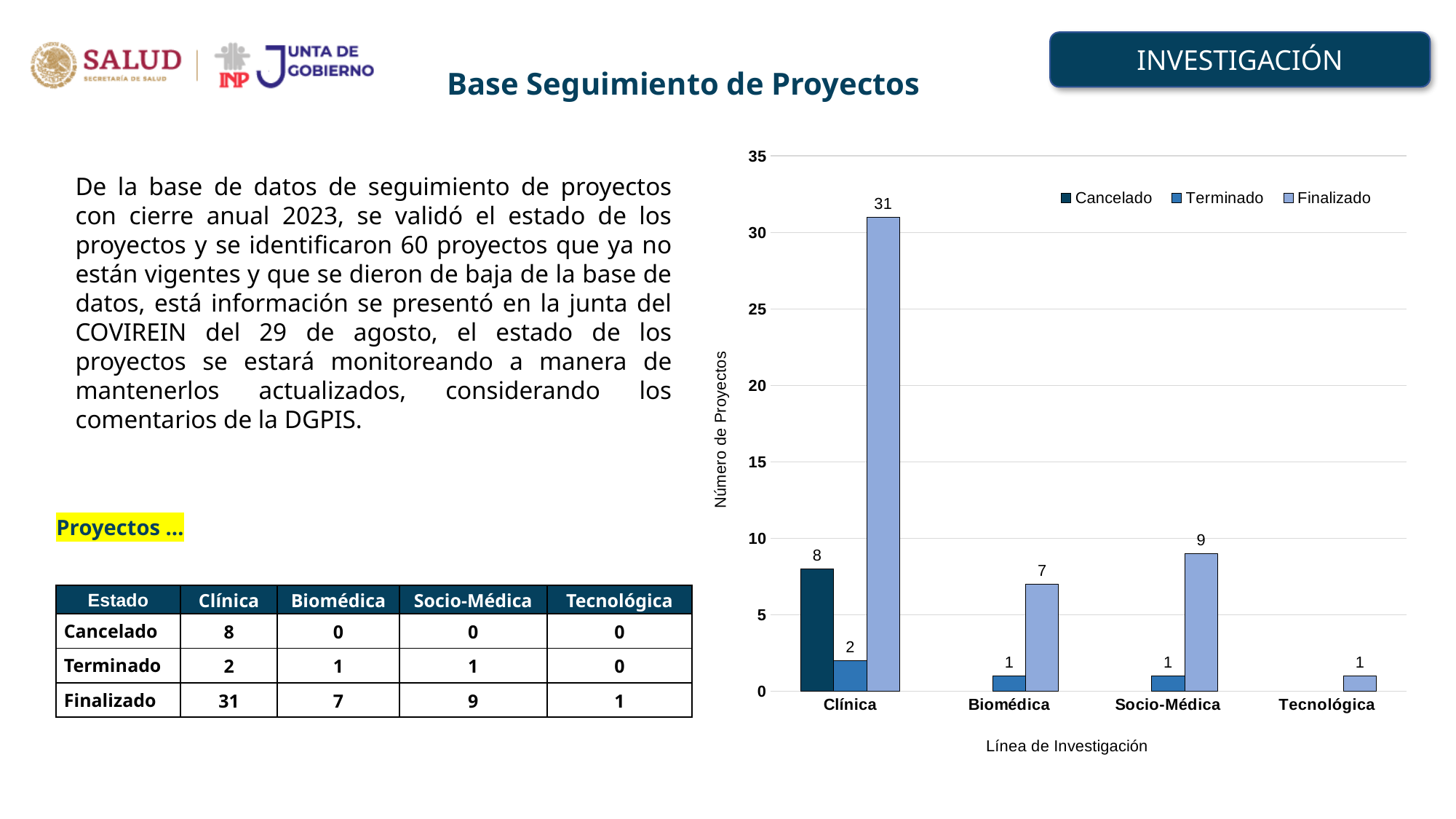
What kind of chart is shown? bar chart What is the Terminado value for Biomédica? 1 How many series does the legend list? 3 What is the Cancelado value for Clínica? 8 What is the Finalizado value for Socio-Médica? 9 Which category has the lowest Finalizado value? Tecnológica Which is larger, the Finalizado value for Biomédica or for Socio-Médica? Socio-Médica What is the Finalizado value for Clínica? 31 What is the difference between the Finalizado values for Clínica and Biomédica? 24 Which category has the highest Finalizado value? Clínica How many categories are shown on the x axis? 4 Is the Finalizado value for Clínica greater or less than 30? greater